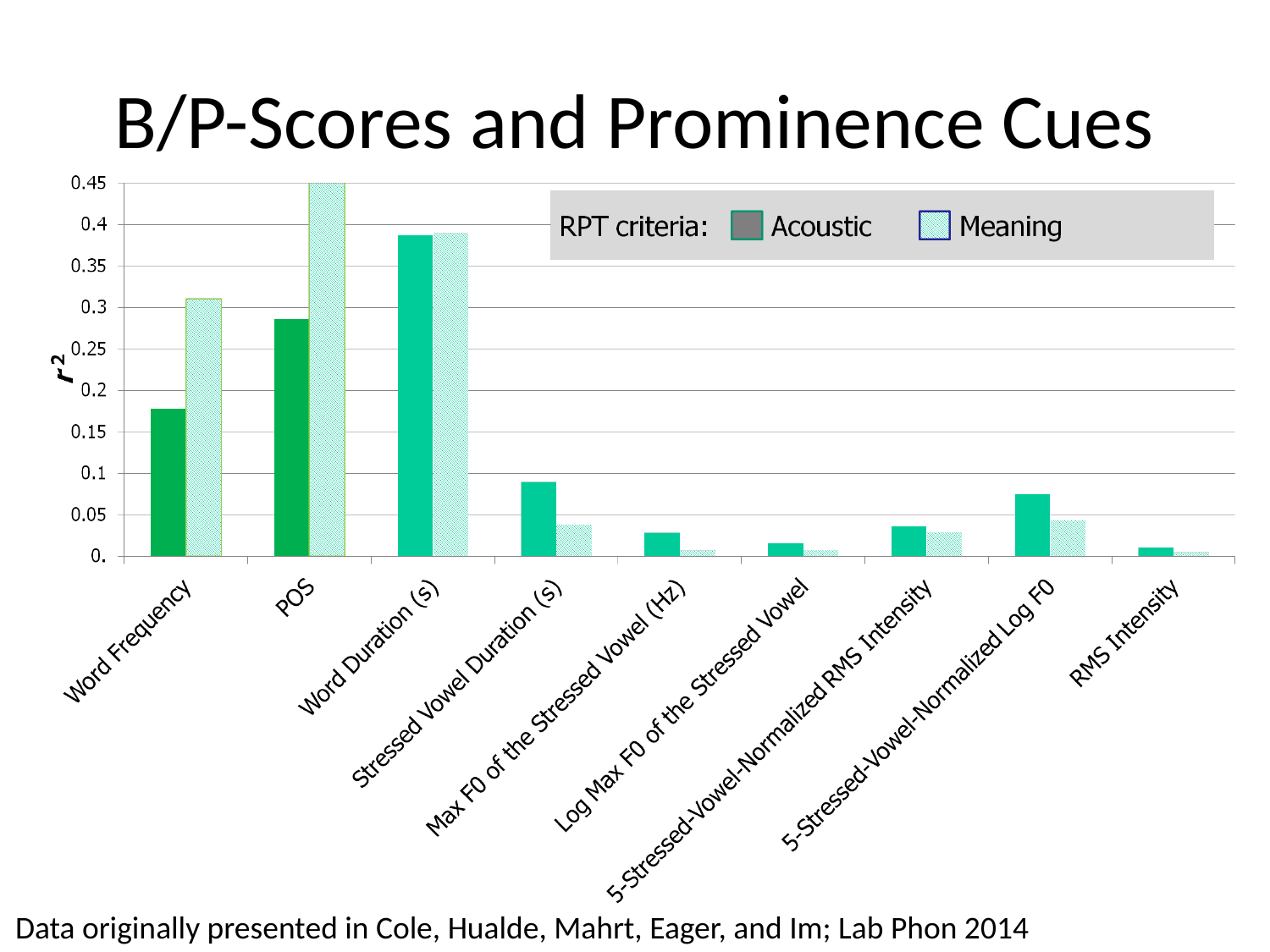
Which category has the highest Meaning value? POS For Word Frequency, which is larger: the Acoustic value or the Meaning value? Meaning Is the Acoustic value for Word Frequency greater or less than 0.2? less What is the label on the chart's y axis? r² For Stressed Vowel Duration (s), which is larger: the Acoustic value or the Meaning value? Acoustic Which category has the highest Acoustic value? Word Duration (s) What kind of chart is shown on the slide? bar chart Is the Acoustic value for Stressed Vowel Duration (s) greater or less than 0.1? less Is the Acoustic value for POS greater or less than 0.25? greater How many series does the chart's legend list? 2 How many categories are shown along the x axis of the chart? 9